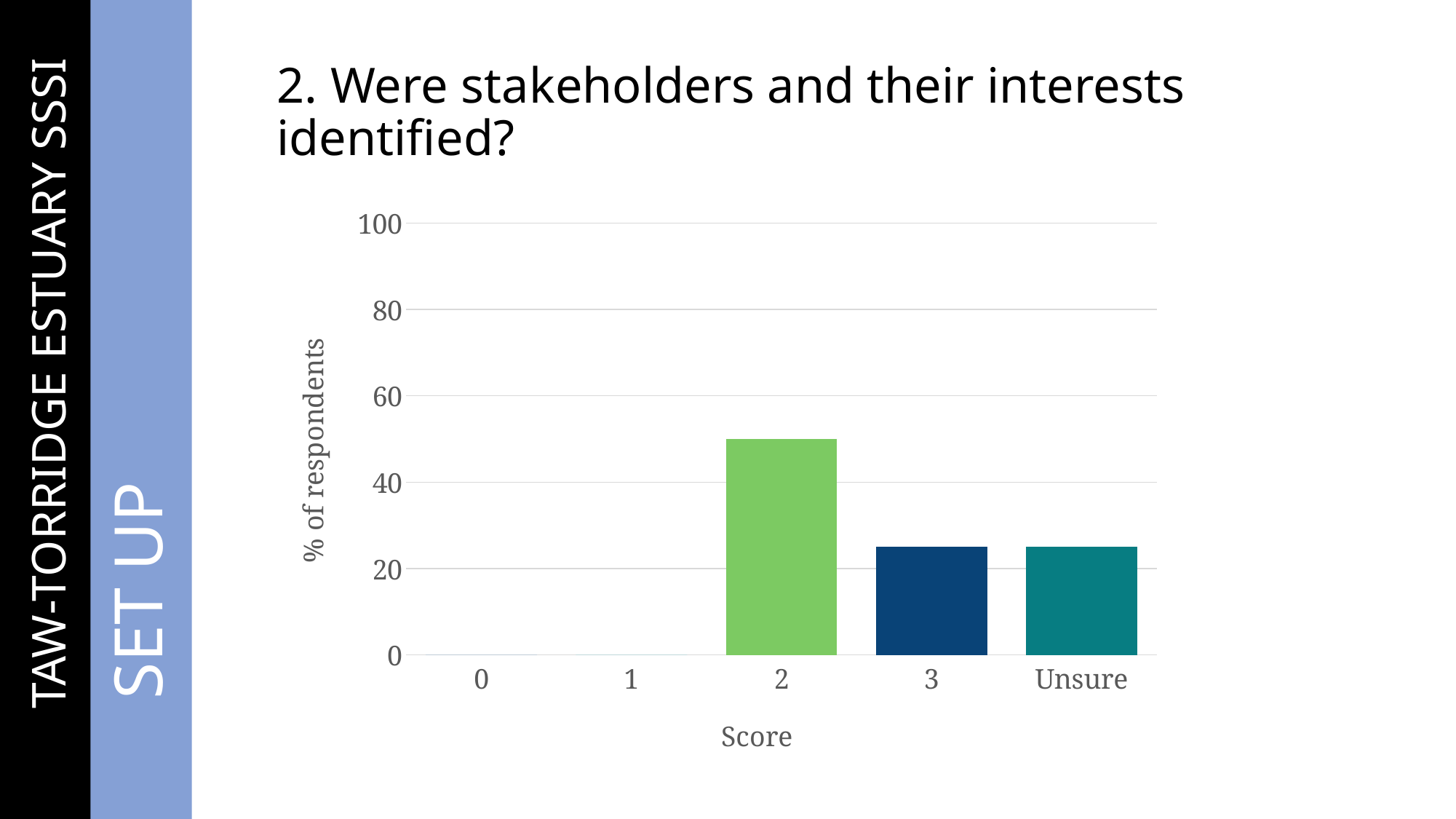
What is the percentage of respondents for score 0? 0 What kind of chart is shown on the slide? bar chart What is the label on the x axis of the chart? Score What is the label on the y axis of the chart? % of respondents Is the value for score 3 greater or less than 40? less Which score category has the highest percentage of respondents? 2 How many score categories are shown on the x axis? 5 Is the value for score 2 greater or less than 60? less Which is larger, the value for score 2 or the value for score 3? score 2 Is the value for Unsure greater or less than 20? greater What is the percentage of respondents for score 1? 0